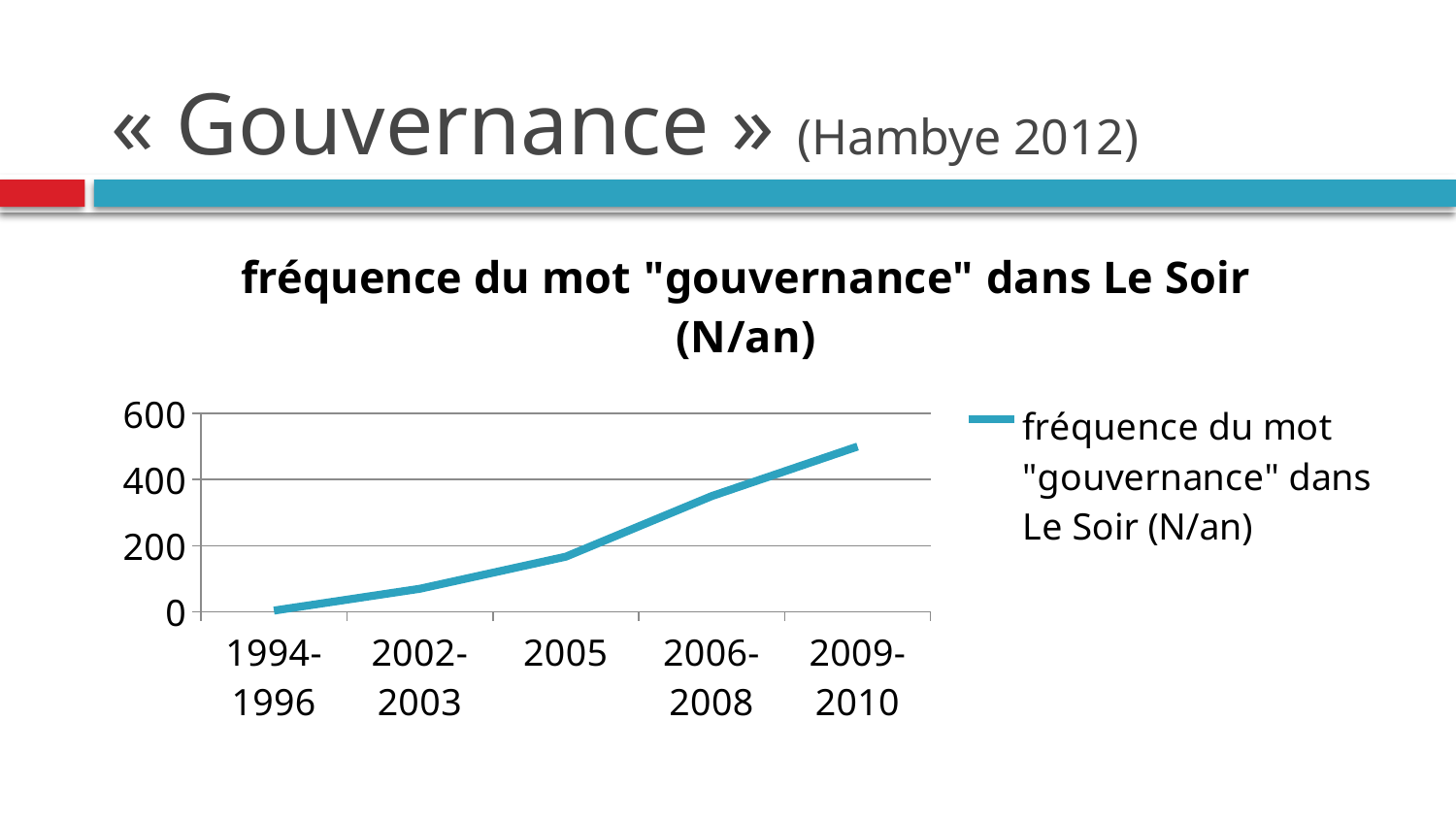
Do the values rise or fall from 1994-1996 to 2009-2010? rise Is the value for 1994-1996 greater or less than 200? less Which is larger, the value for 2005 or the value for 2009-2010? 2009-2010 Is the value for 2006-2008 greater or less than 200? greater What type of chart is shown on the slide? line chart Which period has the lowest frequency of the word "gouvernance"? 1994-1996 How many series does the legend list? 1 What is the title of the chart? fréquence du mot "gouvernance" dans Le Soir (N/an) Is the value for 2005 greater or less than 200? less How many periods are plotted along the x axis? 5 Which period has the highest frequency of the word "gouvernance"? 2009-2010